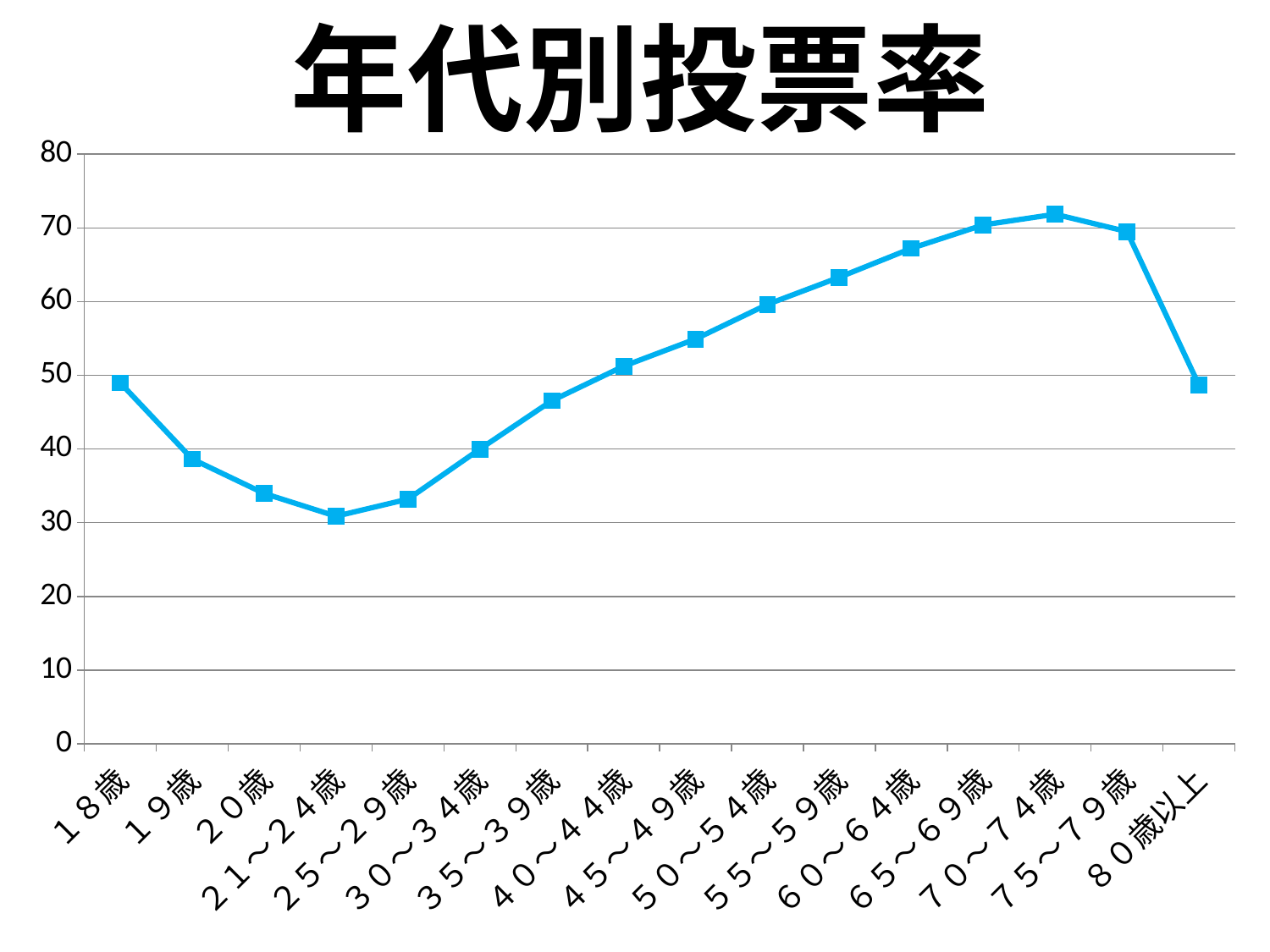
Which age category has the highest voting rate? 70～74歳 Which has the higher voting rate, 19歳 or 20歳? 19歳 Is the value for 19歳 greater or less than 40? less What is the title of the chart? 年代別投票率 Which has the higher voting rate, 45～49歳 or 55～59歳? 55～59歳 Is the value for 35～39歳 greater or less than 40? greater Is the value for 60～64歳 greater or less than 60? greater What kind of chart is shown on the slide? line chart Which age category has the lowest voting rate? 21～24歳 How many age categories are plotted along the x axis? 16 Do the values rise or fall from 21～24歳 to 70～74歳? rise